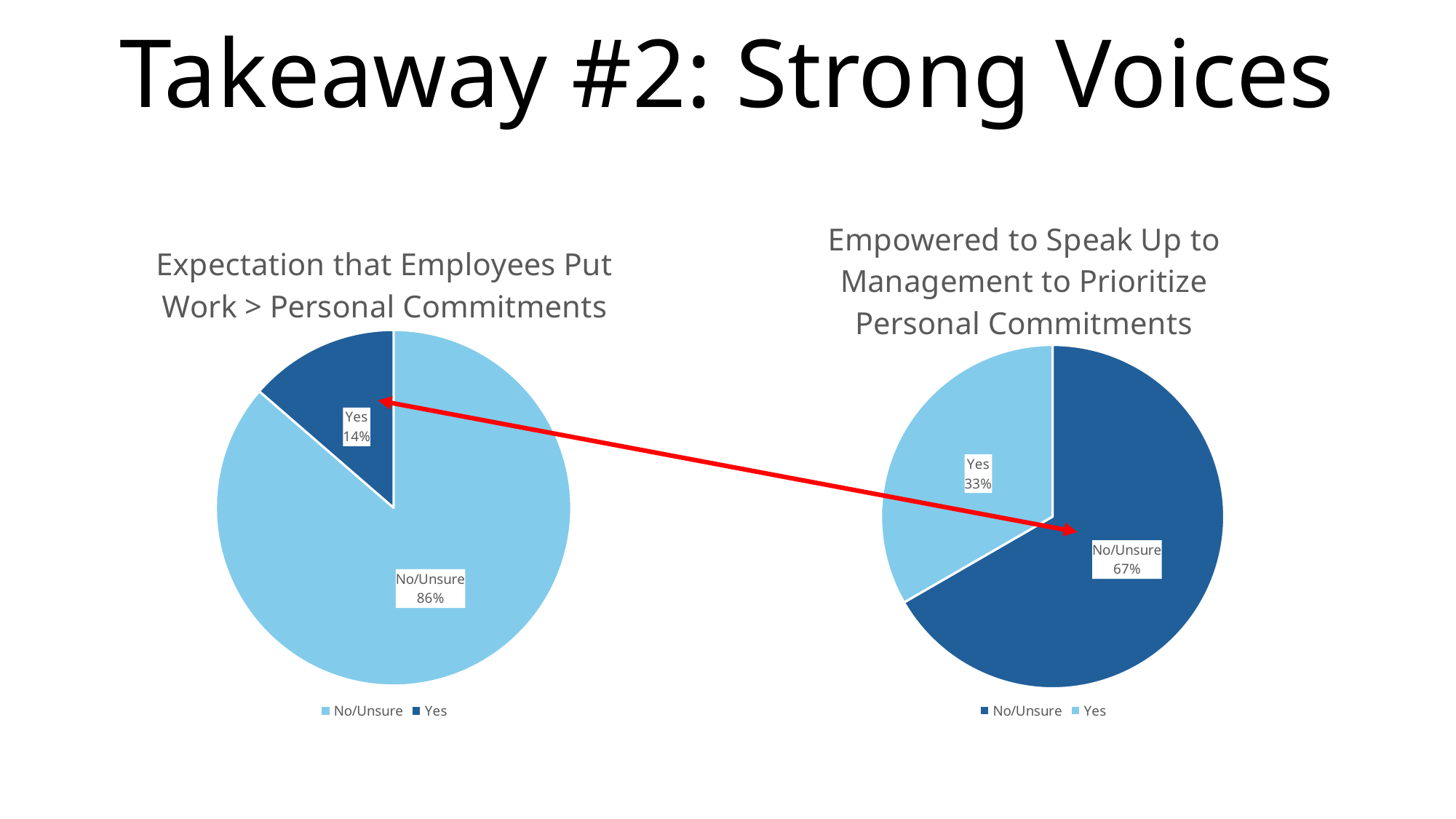
In the left chart, which slice is the largest? No/Unsure In the chart titled "Expectation that Employees Put Work > Personal Commitments", what share of the pie is labelled Yes? 14% In the chart titled "Expectation that Employees Put Work > Personal Commitments", what share of the pie is labelled No/Unsure? 86% How many entries does the legend of the left chart list? 2 What type of chart is used on the left of the slide? pie chart In the chart titled "Empowered to Speak Up to Management to Prioritize Personal Commitments", what share of the pie is labelled No/Unsure? 67% Is the Yes share larger in the left chart or the right chart? the right chart In the right chart, which slice is the smallest? Yes How many slices does the right chart have? 2 In the chart titled "Empowered to Speak Up to Management to Prioritize Personal Commitments", what share of the pie is labelled Yes? 33% In the right chart, what is the difference between the No/Unsure share and the Yes share? 34% In the left chart, what is the difference between the No/Unsure share and the Yes share? 72%